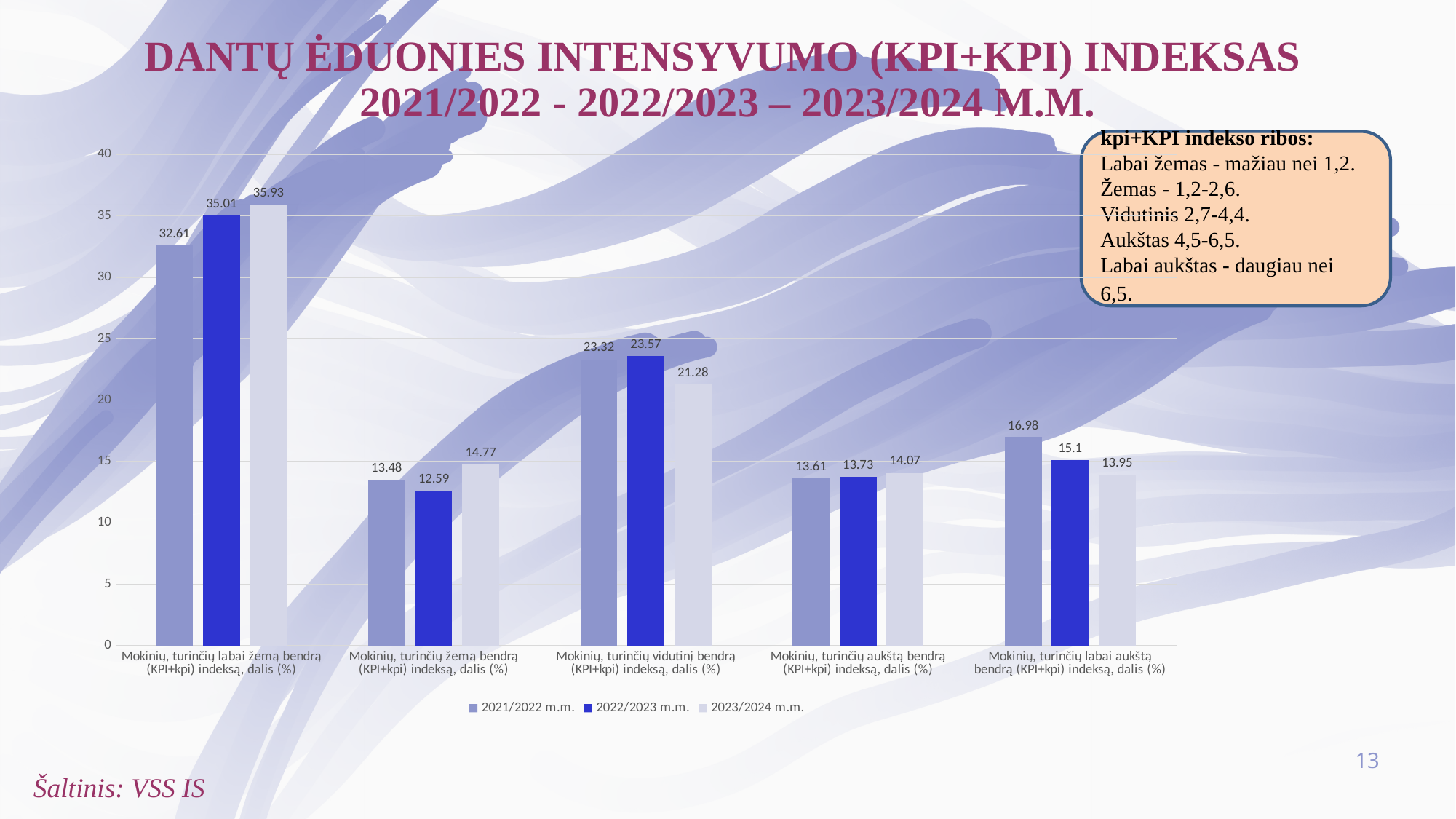
Which category has the highest value for the 2021/2022 m.m. series? Mokinių, turinčių labai žemą bendrą (KPI+kpi) indeksą, dalis (%) What is the difference between the 2023/2024 m.m. and 2021/2022 m.m. values in the category "Mokinių, turinčių labai žemą bendrą (KPI+kpi) indeksą, dalis (%)"? 3.32 What is the value for 2021/2022 m.m. in the category "Mokinių, turinčių labai aukštą bendrą (KPI+kpi) indeksą, dalis (%)"? 16.98 Across the three school years, do the values for "Mokinių, turinčių labai aukštą bendrą (KPI+kpi) indeksą, dalis (%)" rise or fall? fall How many categories are shown on the x axis of the chart? 5 What is the value for 2023/2024 m.m. in the category "Mokinių, turinčių labai žemą bendrą (KPI+kpi) indeksą, dalis (%)"? 35.93 What is the value for 2022/2023 m.m. in the category "Mokinių, turinčių žemą bendrą (KPI+kpi) indeksą, dalis (%)"? 12.59 Is the 2021/2022 m.m. value for "Mokinių, turinčių aukštą bendrą (KPI+kpi) indeksą, dalis (%)" greater or less than 15? less Which category has the lowest value for the 2022/2023 m.m. series? Mokinių, turinčių žemą bendrą (KPI+kpi) indeksą, dalis (%) What kind of chart is shown on the slide? bar chart How many series does the legend list? 3 In the category "Mokinių, turinčių vidutinį bendrą (KPI+kpi) indeksą, dalis (%)", which is larger: the 2022/2023 m.m. value or the 2023/2024 m.m. value? 2022/2023 m.m.